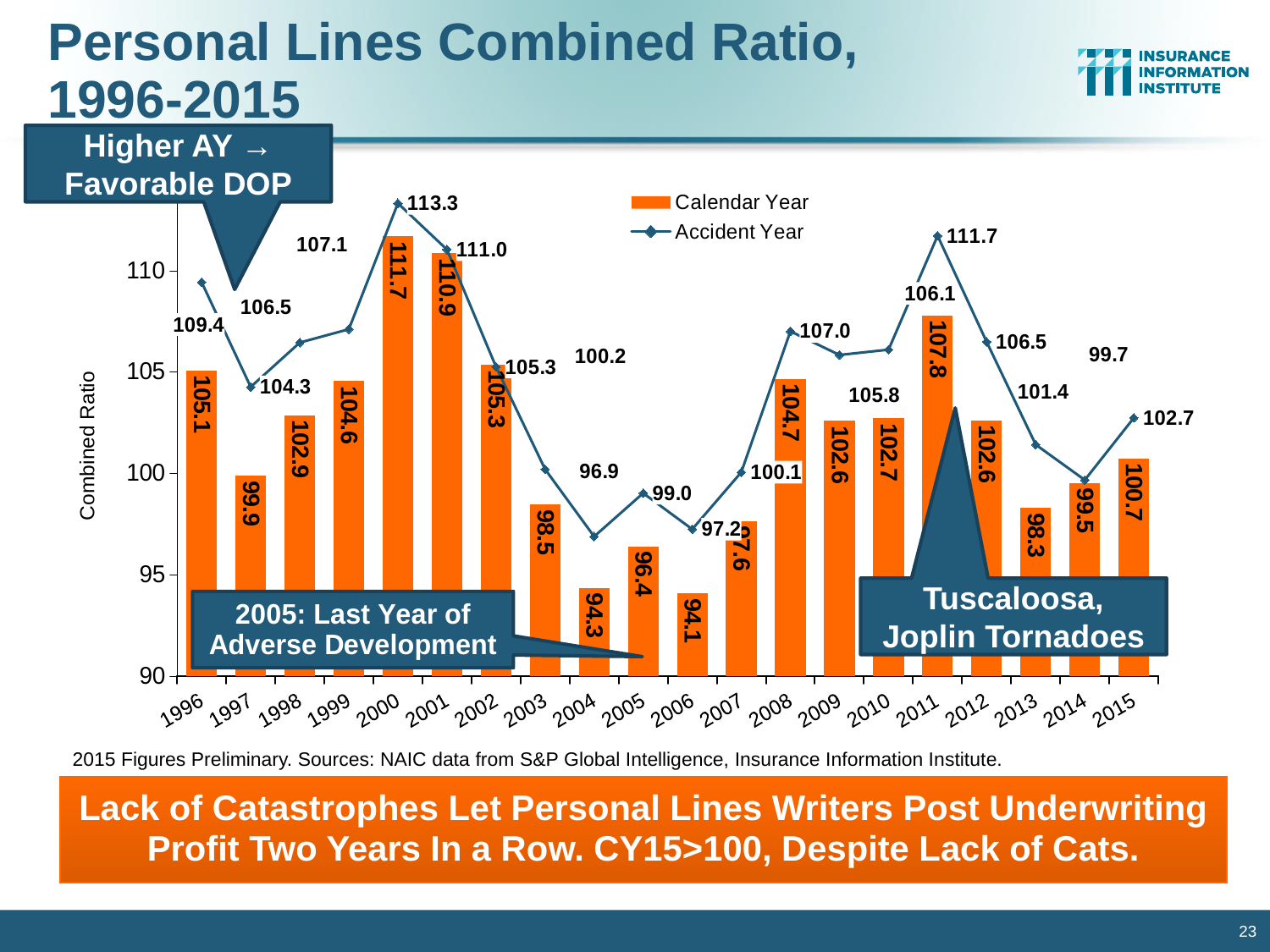
Which year has the lowest Calendar Year combined ratio? 2006 Which year has the highest Calendar Year combined ratio? 2000 What is the Calendar Year combined ratio for 2000? 111.7 What is the Calendar Year combined ratio for 2015? 100.7 How many years are shown on the x axis of the chart? 20 What is the Accident Year combined ratio for 2011? 111.7 How many series does the legend list? 2 What is the difference between the Accident Year and Calendar Year combined ratios in 2015? 2.0 Does the Calendar Year combined ratio rise or fall from 2011 to 2013? Fall Which year has the highest Accident Year combined ratio? 2000 In 2011, which is larger: the Calendar Year or the Accident Year combined ratio? Accident Year What kind of chart is shown on the slide? Combined bar and line chart